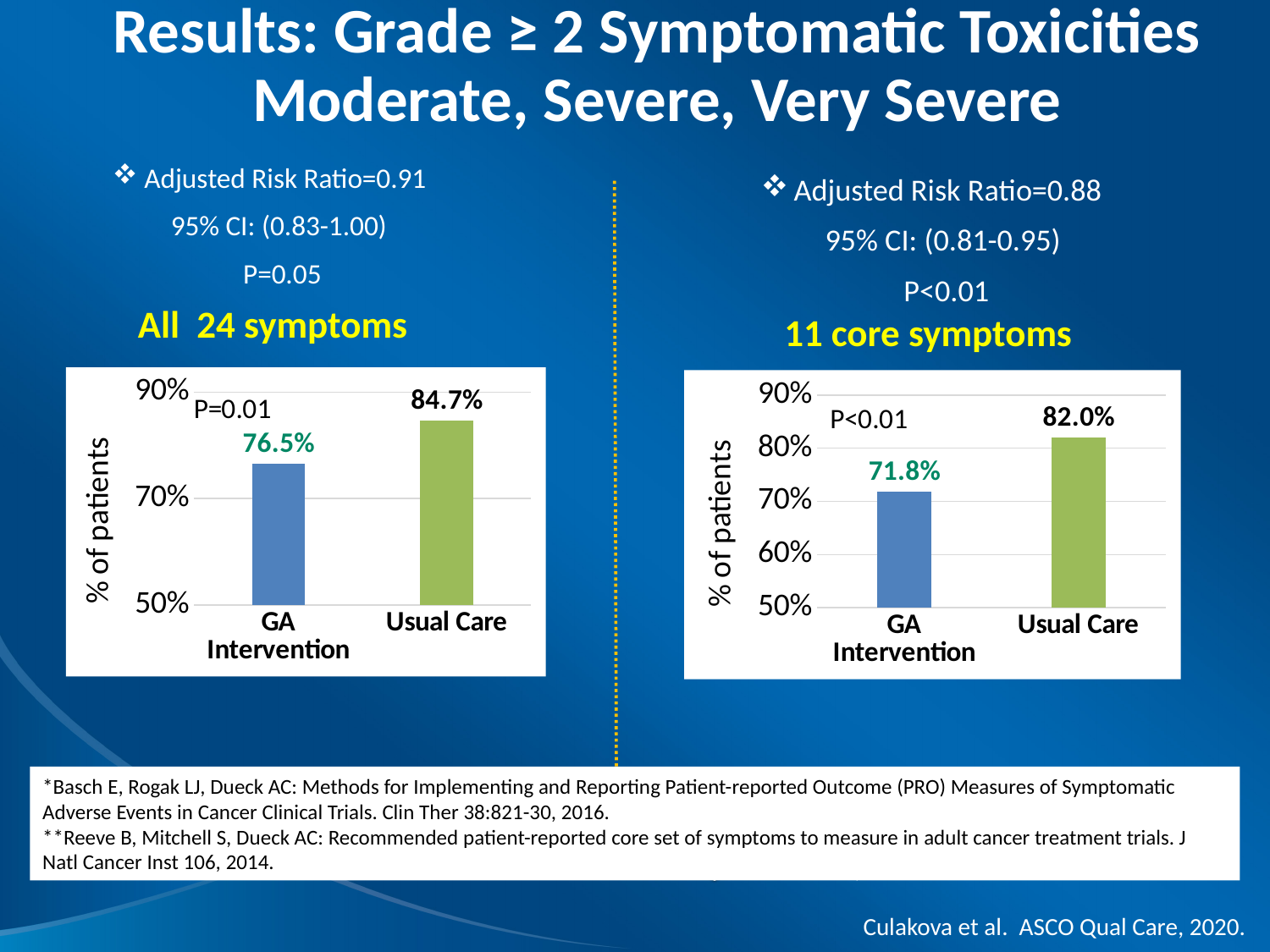
What kind of chart is the '11 core symptoms' chart? Bar chart In the '11 core symptoms' chart, is the value for GA Intervention greater or less than 80%? less In the 'All 24 symptoms' chart, what is the value for GA Intervention? 76.5% In the '11 core symptoms' chart, which category has the lower value? GA Intervention In the 'All 24 symptoms' chart, what is the value for Usual Care? 84.7% In the '11 core symptoms' chart, what is the difference between Usual Care and GA Intervention? 10.2% How many categories are shown in the 'All 24 symptoms' chart? 2 In the 'All 24 symptoms' chart, what is the difference between Usual Care and GA Intervention? 8.2% In the '11 core symptoms' chart, what is the value for GA Intervention? 71.8% In the '11 core symptoms' chart, what is the value for Usual Care? 82.0% In the 'All 24 symptoms' chart, which category has the higher value? Usual Care What is the y-axis label of the 'All 24 symptoms' chart? % of patients